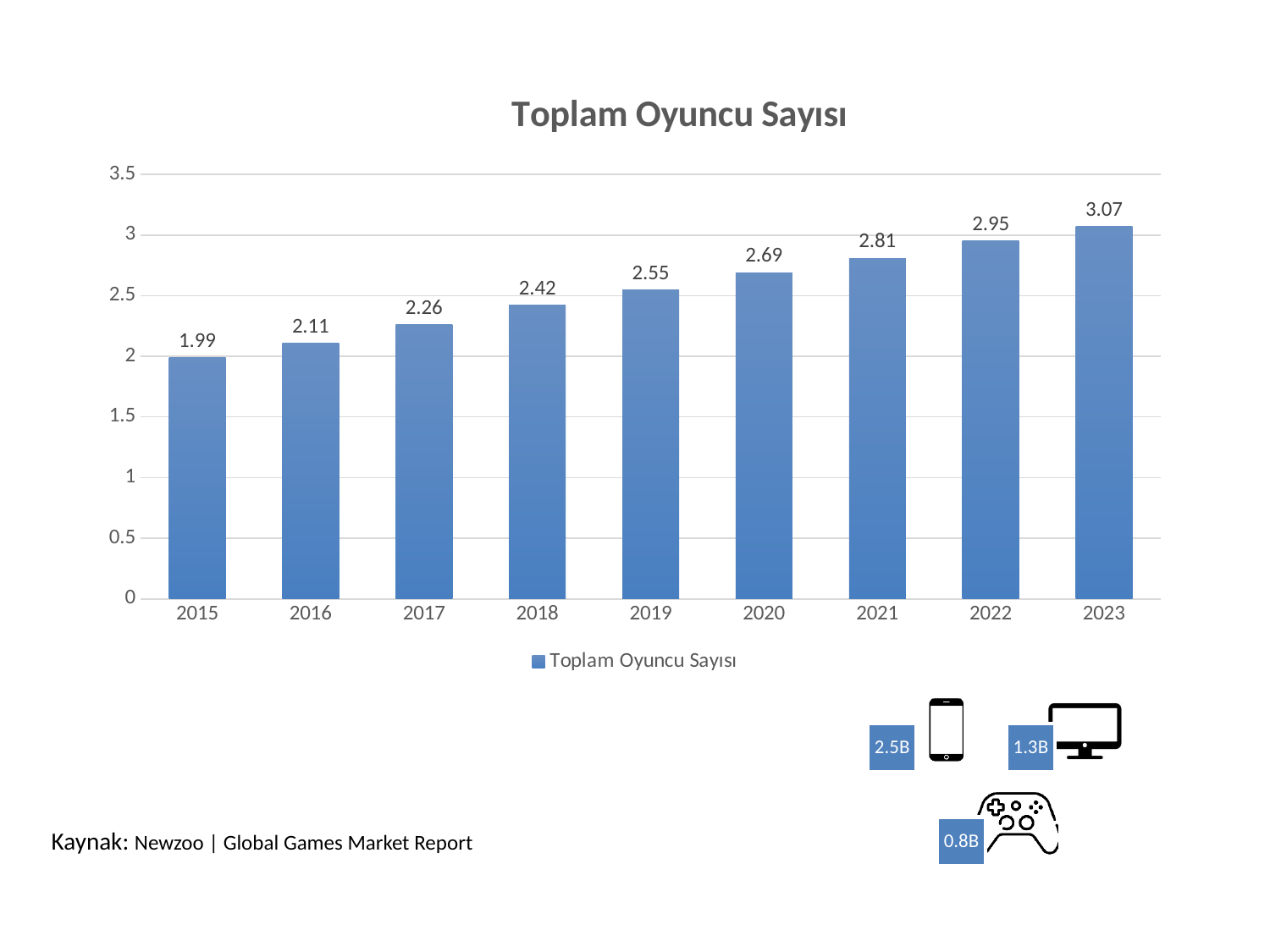
What is the value for 2019? 2.55 How many years are shown on the x axis? 9 Is the value for 2022 greater or less than 3? less What is the difference between the values for 2021 and 2020? 0.12 Which year has the lowest value? 2015 Do the values rise or fall from 2015 to 2023? rise What kind of chart is this? bar chart What is the difference between the values for 2023 and 2015? 1.08 What is the value for 2023? 3.07 Which year has the highest value? 2023 What is the value for 2015? 1.99 Which is larger, the value for 2017 or the value for 2018? 2018